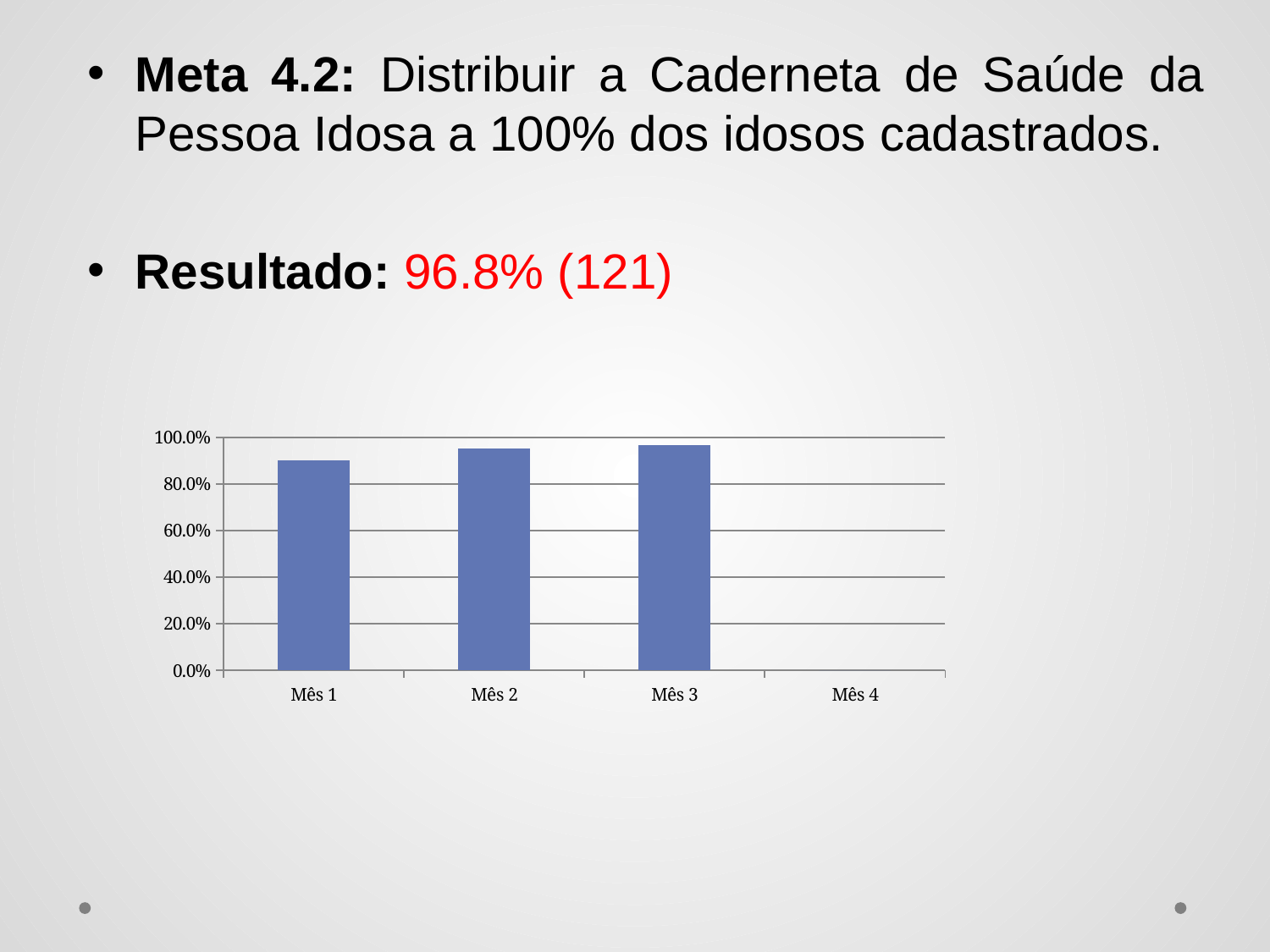
Which is larger, the value for Mês 1 or the value for Mês 3? Mês 3 Is the value for Mês 1 greater or less than 80.0%? greater How many categories are shown on the x axis of the chart? 4 What kind of chart is shown on the slide? bar chart Is the value for Mês 2 greater or less than 80.0%? greater Is the value for Mês 1 greater or less than 100.0%? less Which is larger, the value for Mês 1 or the value for Mês 2? Mês 2 Do the bar values rise or fall from Mês 1 to Mês 3? rise Which category on the x axis has no bar plotted? Mês 4 What is the highest value shown on the y axis of the chart? 100.0%